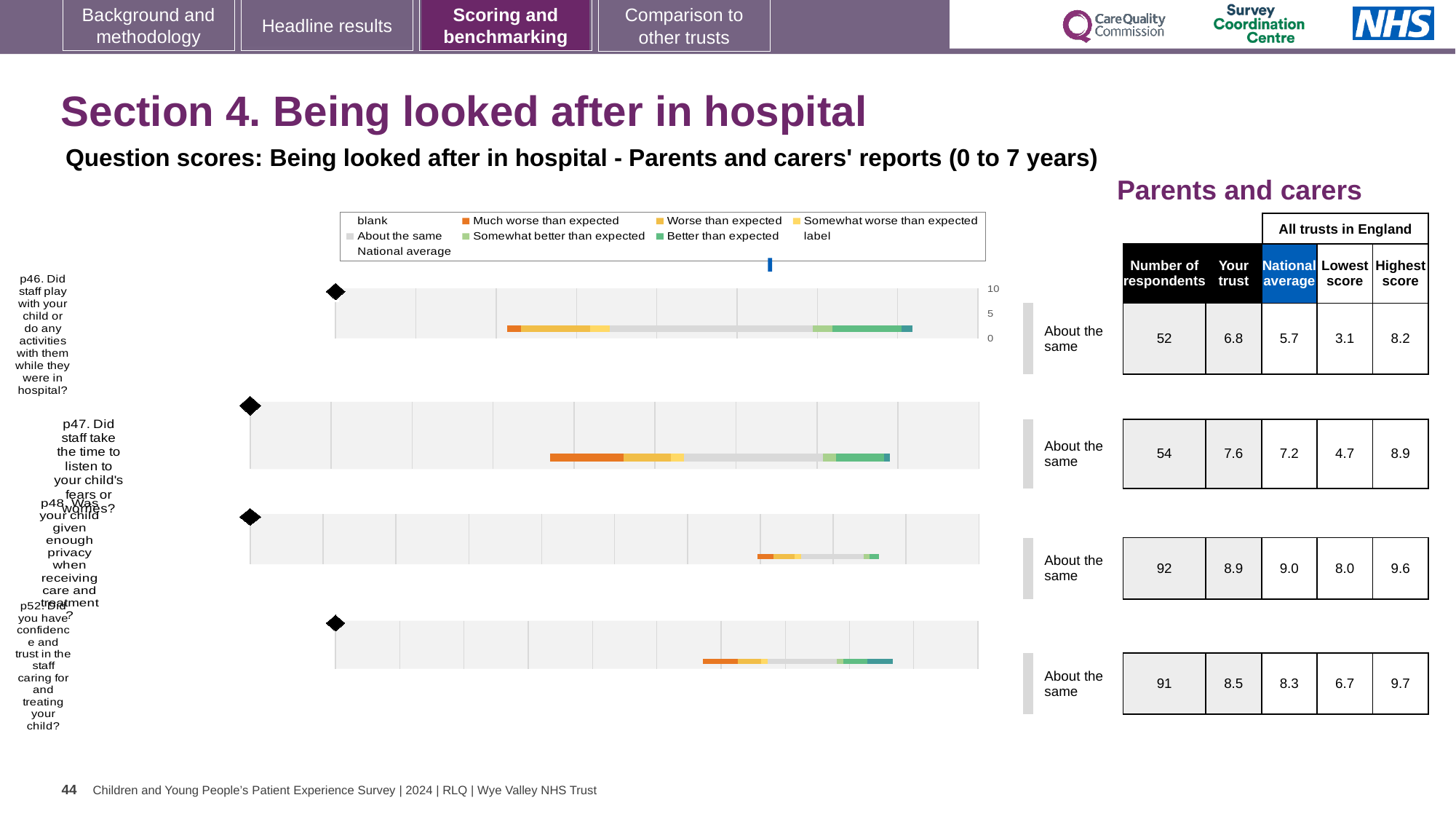
How many questions are plotted on the slide? 4 Which question has the lowest 'Your trust' score? p46 What benchmark category is shown for p48 (Was your child given enough privacy when receiving care and treatment?)? About the same For p47, what is the difference between the 'Your trust' score and the national average? 0.4 What kind of chart is used to show the question scores? Bar chart How many respondents answered p48 (Was your child given enough privacy when receiving care and treatment?)? 92 What is the national average score for p47 (Did staff take the time to listen to your child's fears or worries?)? 7.2 What is the highest score across all trusts in England for p52 (Did you have confidence and trust in the staff caring for and treating your child?)? 9.7 For p46, what is the difference between the highest score and the lowest score across all trusts in England? 5.1 What is the 'Your trust' score for p46 (Did staff play with your child or do any activities with them while they were in hospital?)? 6.8 Which question has the highest 'Your trust' score? p48 For p52, which is larger: the 'Your trust' score or the national average? Your trust